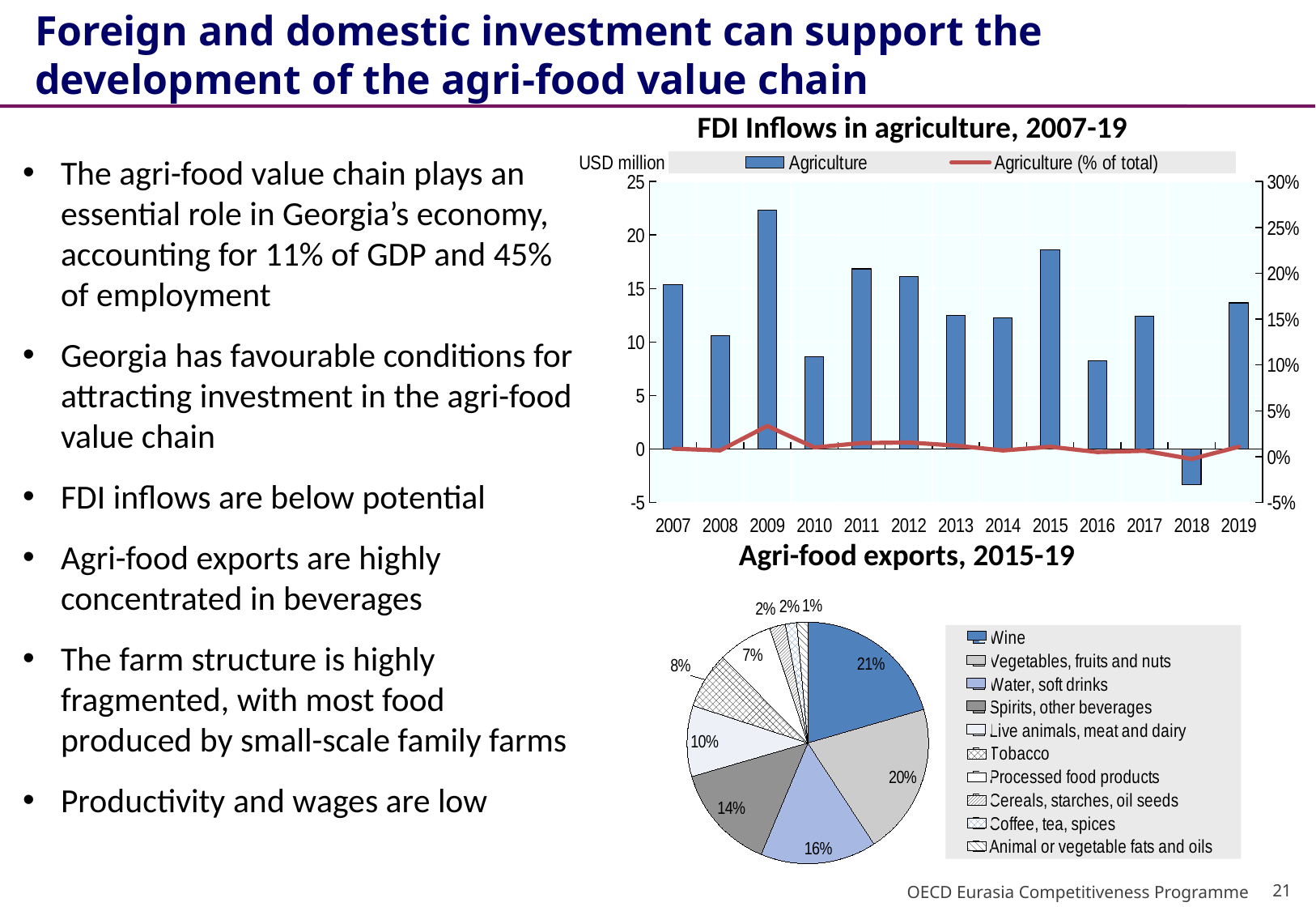
In the 'Agri-food exports, 2015-19' pie chart, what share does Water, soft drinks have? 16% In the 'FDI Inflows in agriculture, 2007-19' chart, is the Agriculture value for 2018 greater or less than 0? less In the 'Agri-food exports, 2015-19' pie chart, what share does Wine have? 21% In the 'Agri-food exports, 2015-19' pie chart, what is the difference between the Wine share and the Spirits, other beverages share? 7% What kind of chart is 'Agri-food exports, 2015-19'? Pie chart How many years are shown on the x axis of the 'FDI Inflows in agriculture, 2007-19' chart? 13 In the 'FDI Inflows in agriculture, 2007-19' chart, which year has the highest Agriculture bar? 2009 In the 'FDI Inflows in agriculture, 2007-19' chart, which is larger, the Agriculture bar for 2015 or for 2016? 2015 In the 'FDI Inflows in agriculture, 2007-19' chart, is the Agriculture value for 2016 greater or less than 10? less How many series does the legend of the 'FDI Inflows in agriculture, 2007-19' chart list? 2 In the 'FDI Inflows in agriculture, 2007-19' chart, is the Agriculture value for 2009 greater or less than 20? greater In the 'FDI Inflows in agriculture, 2007-19' chart, which year has the lowest Agriculture bar? 2018